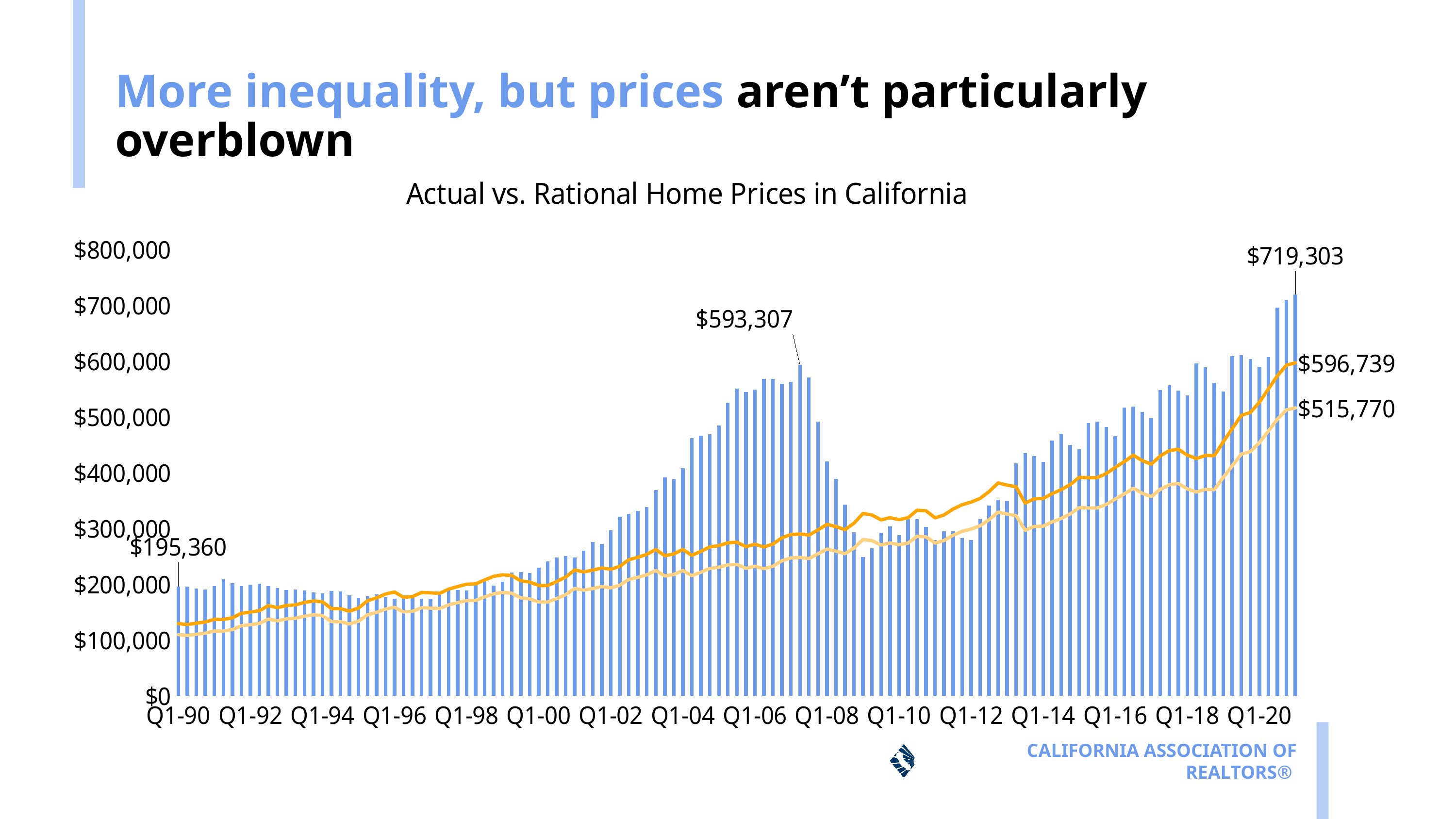
What is the difference between the $719,303 bar and the $593,307 bar? $125,996 What is the labeled end value of the darker orange line? $596,739 What is the labeled value of the tallest bar, at the right end of the chart? $719,303 What kind of chart is shown on the slide? A bar chart combined with line series What is the labeled end value of the lighter orange line? $515,770 Is the bar value at Q1-10 greater or less than $400,000? less What is the labeled value of the bar at the peak before the decline around Q1-08? $593,307 What is the difference between the two labeled line end values, $596,739 and $515,770? $80,969 What is the title of the chart? Actual vs. Rational Home Prices in California What is the labeled value of the first bar, at Q1-90? $195,360 Which is larger, the labeled bar value $593,307 or the labeled bar value $719,303? $719,303 Do the bar values generally rise or fall from Q1-12 to Q1-20? rise